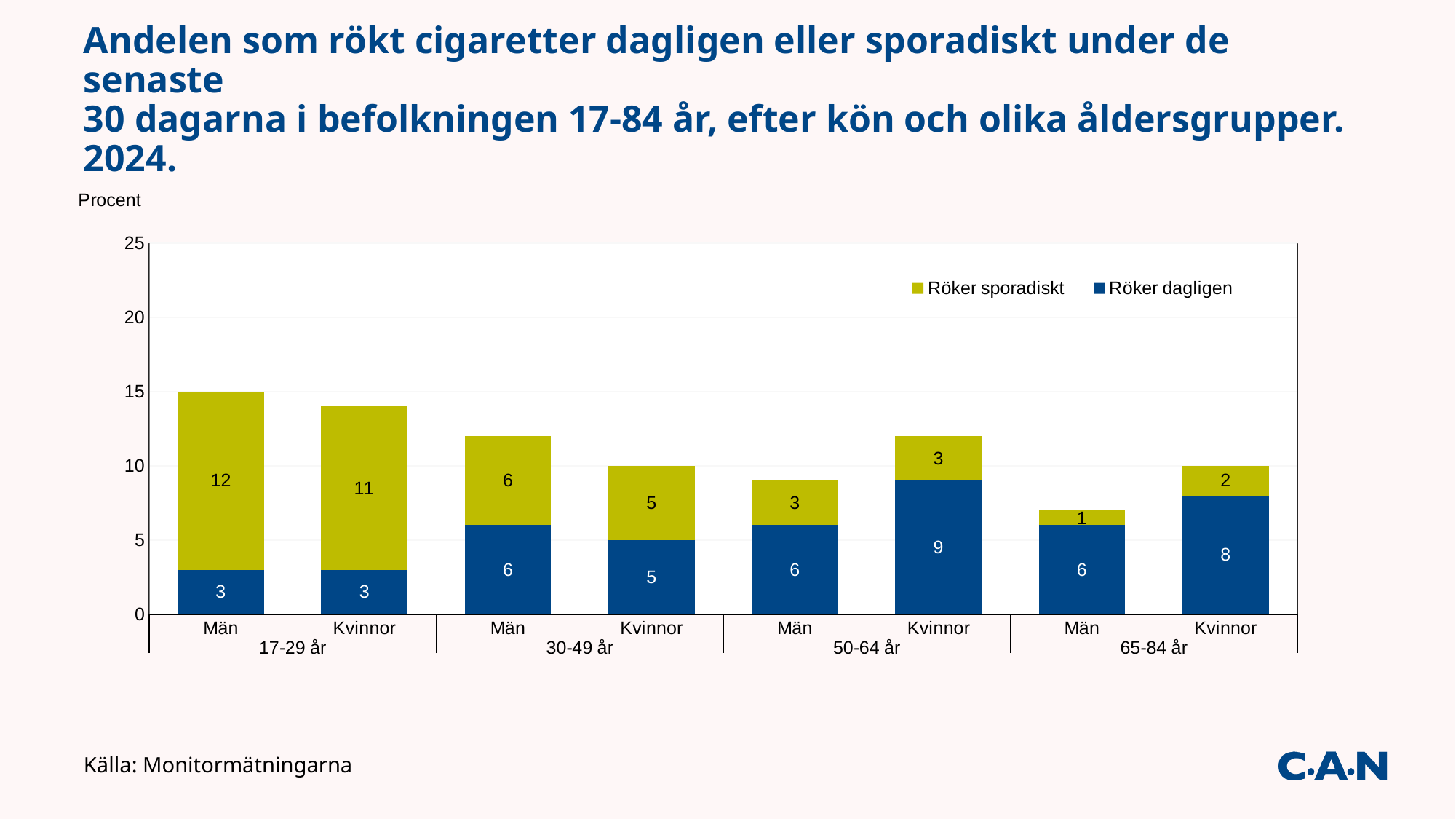
What is the total height of the stacked bar for Kvinnor in the 17-29 år group? 14 What is the value of Röker sporadiskt for Män in the 17-29 år group? 12 What is the difference between the Röker dagligen values for Kvinnor and Män in the 65-84 år group? 2 What is the value of Röker dagligen for Kvinnor in the 50-64 år group? 9 Which is larger: the Röker dagligen value for Kvinnor in the 50-64 år group or for Kvinnor in the 30-49 år group? Kvinnor, 50-64 år Which bar has the highest Röker sporadiskt value? Män, 17-29 år What is the total height of the stacked bar for Män in the 50-64 år group? 9 Which bar has the lowest Röker sporadiskt value? Män, 65-84 år What is the value of Röker sporadiskt for Män in the 65-84 år group? 1 How many bars are plotted in the chart? 8 What type of chart is shown on the slide? Stacked bar chart How many series does the legend list? 2